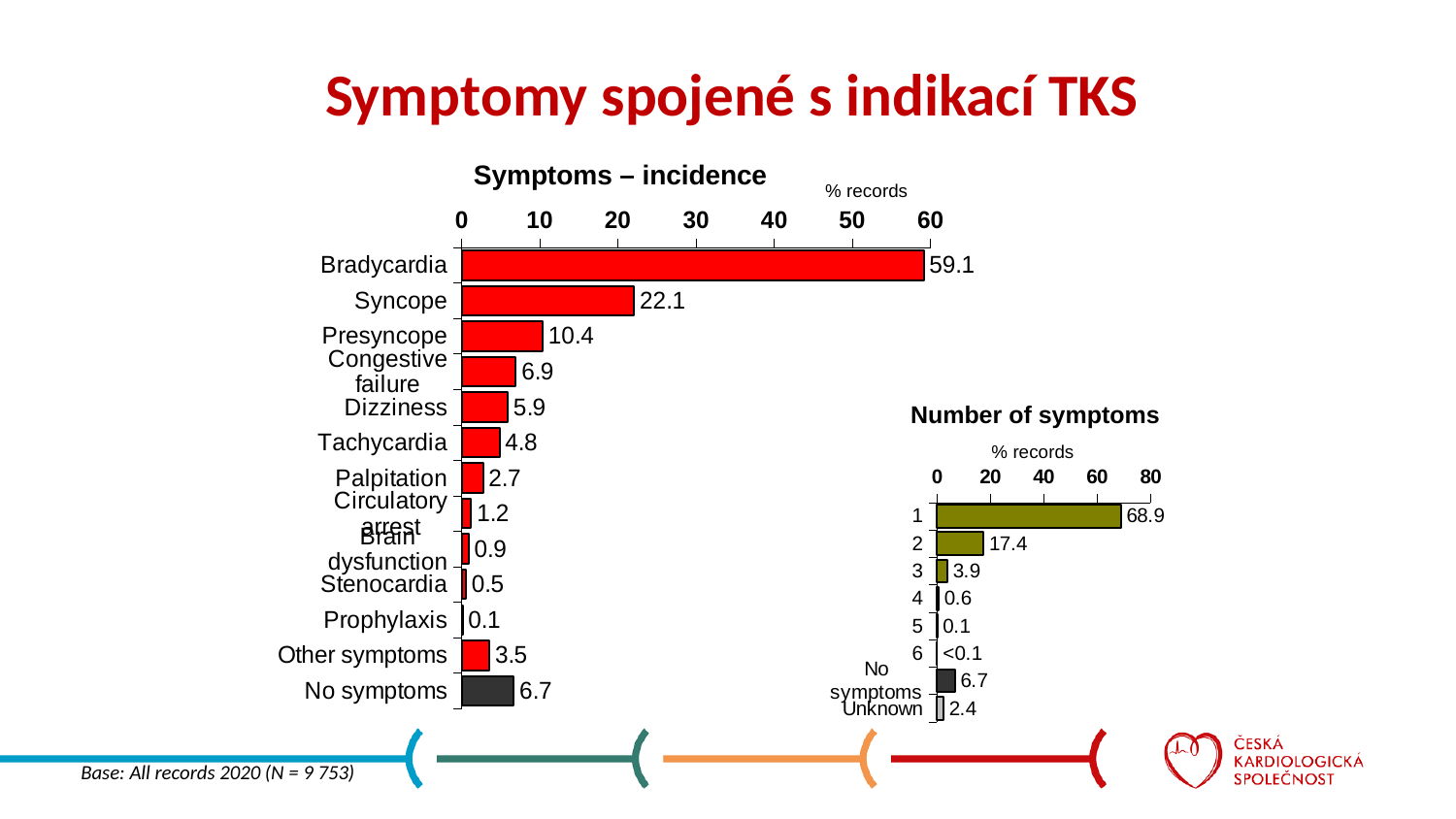
In the 'Symptoms – incidence' chart, what is the value for Bradycardia? 59.1 In the 'Symptoms – incidence' chart, which is larger: Dizziness or Tachycardia? Dizziness How many categories are shown in the 'Symptoms – incidence' chart? 13 In the 'Symptoms – incidence' chart, which symptom has the highest value? Bradycardia In the 'Number of symptoms' chart, what is the value for 1 symptom? 68.9 What type of chart is the 'Symptoms – incidence' chart? Bar chart In the 'Symptoms – incidence' chart, which category has the lowest value? Prophylaxis In the 'Symptoms – incidence' chart, what is the difference between the values for Syncope and Presyncope? 11.7 In the 'Symptoms – incidence' chart, what is the value for Syncope? 22.1 In the 'Number of symptoms' chart, what is the difference between the values for 1 and 2 symptoms? 51.5 How many categories are shown in the 'Number of symptoms' chart? 8 In the 'Number of symptoms' chart, what is the value for Unknown? 2.4